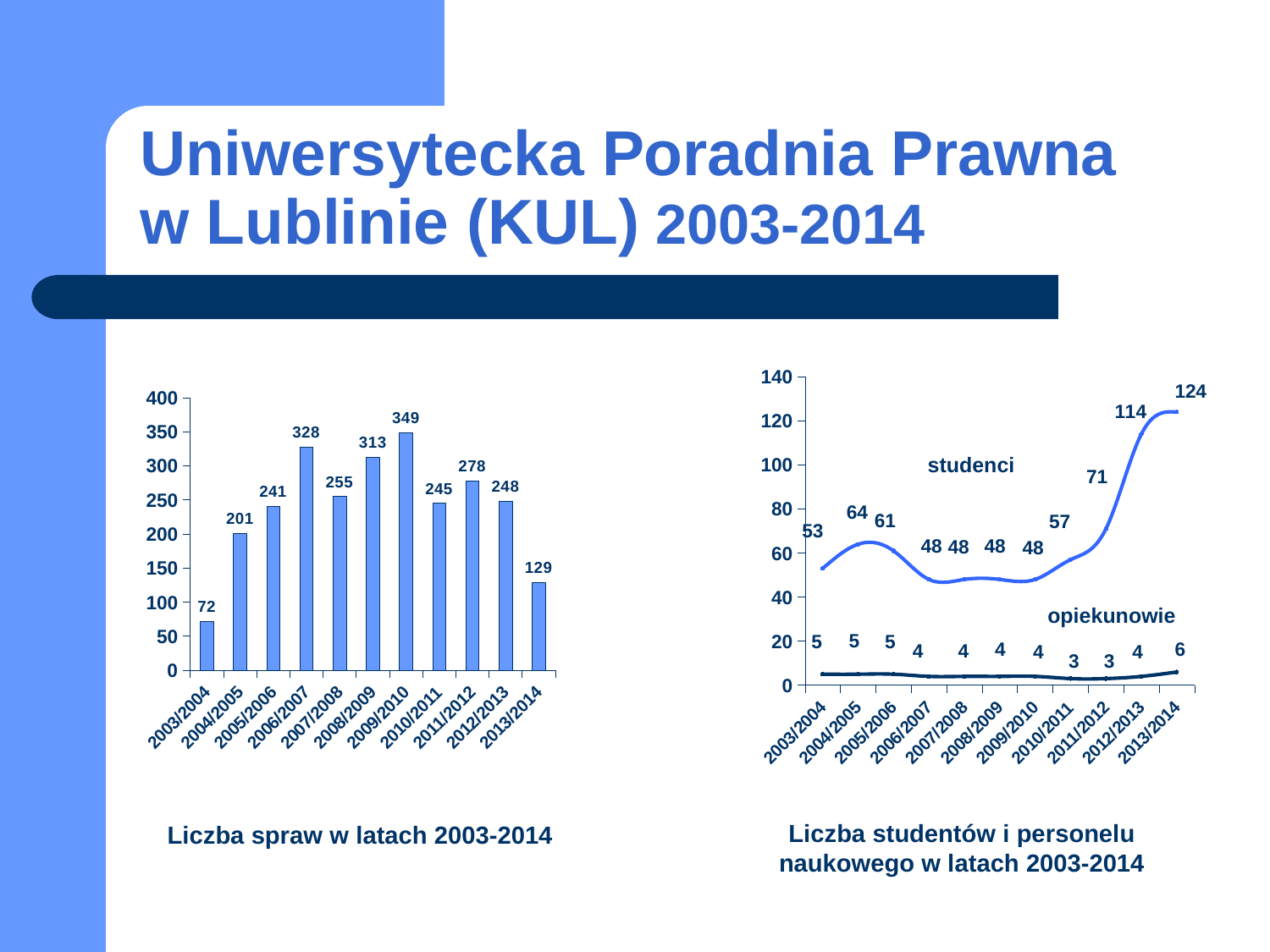
In the left chart (Liczba spraw w latach 2003-2014), what is the difference between the values for 2009/2010 and 2013/2014? 220 In the left chart (Liczba spraw w latach 2003-2014), which year has the lowest value? 2003/2004 In the right chart (Liczba studentów i personelu naukowego), how many series are plotted? 2 How many bars are shown in the left chart (Liczba spraw w latach 2003-2014)? 11 In the left chart (Liczba spraw w latach 2003-2014), what is the value for 2006/2007? 328 In the right chart (Liczba studentów i personelu naukowego), what is the value for studenci in 2013/2014? 124 What type of chart is the left chart (Liczba spraw w latach 2003-2014)? bar chart In the left chart (Liczba spraw w latach 2003-2014), which year has the highest number of cases? 2009/2010 In the right chart (Liczba studentów i personelu naukowego), what is the difference between studenci and opiekunowie in 2012/2013? 110 In the right chart (Liczba studentów i personelu naukowego), what is the value for opiekunowie in 2010/2011? 3 In the left chart (Liczba spraw w latach 2003-2014), which is larger, the value for 2011/2012 or the value for 2012/2013? 2011/2012 In the right chart (Liczba studentów i personelu naukowego), does the studenci series rise or fall from 2010/2011 to 2013/2014? rise